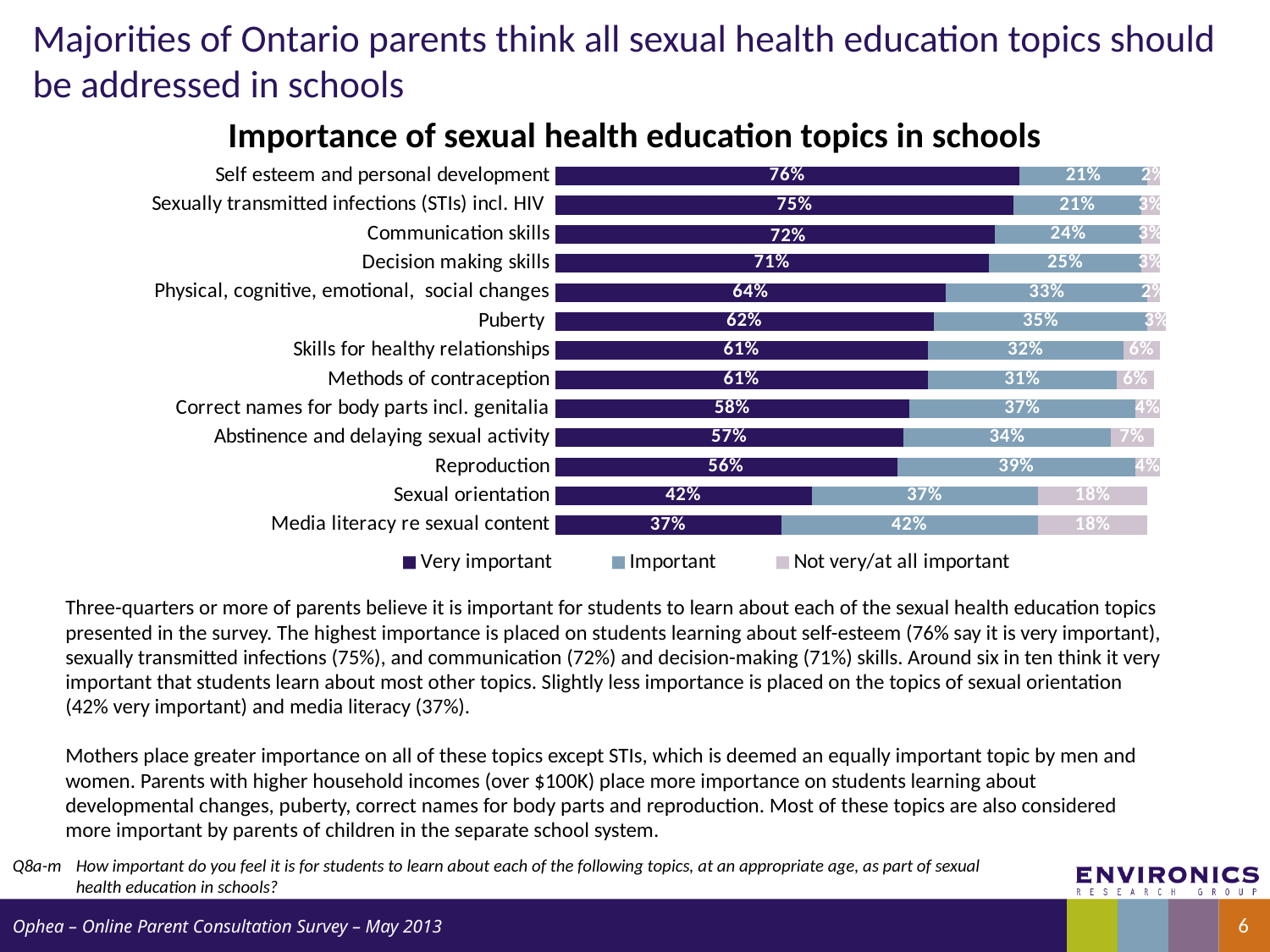
What is the title of the chart? Importance of sexual health education topics in schools Which has a larger very important percentage: Puberty or Abstinence and delaying sexual activity? Puberty What kind of chart is shown on the slide? Stacked bar chart What is the combined percentage of very important and important for Methods of contraception? 92% How many series does the legend list? 3 What is the difference between the very important percentages for Communication skills and Reproduction? 16% What percentage of parents say Self esteem and personal development is very important? 76% Which topic has the highest share of parents saying it is very important? Self esteem and personal development How many topics are listed in the chart? 13 What percentage of parents rate Media literacy re sexual content as important (the middle segment)? 42% Which topic has the lowest share of parents saying it is very important? Media literacy re sexual content What percentage of parents say Sexual orientation is not very/at all important? 18%